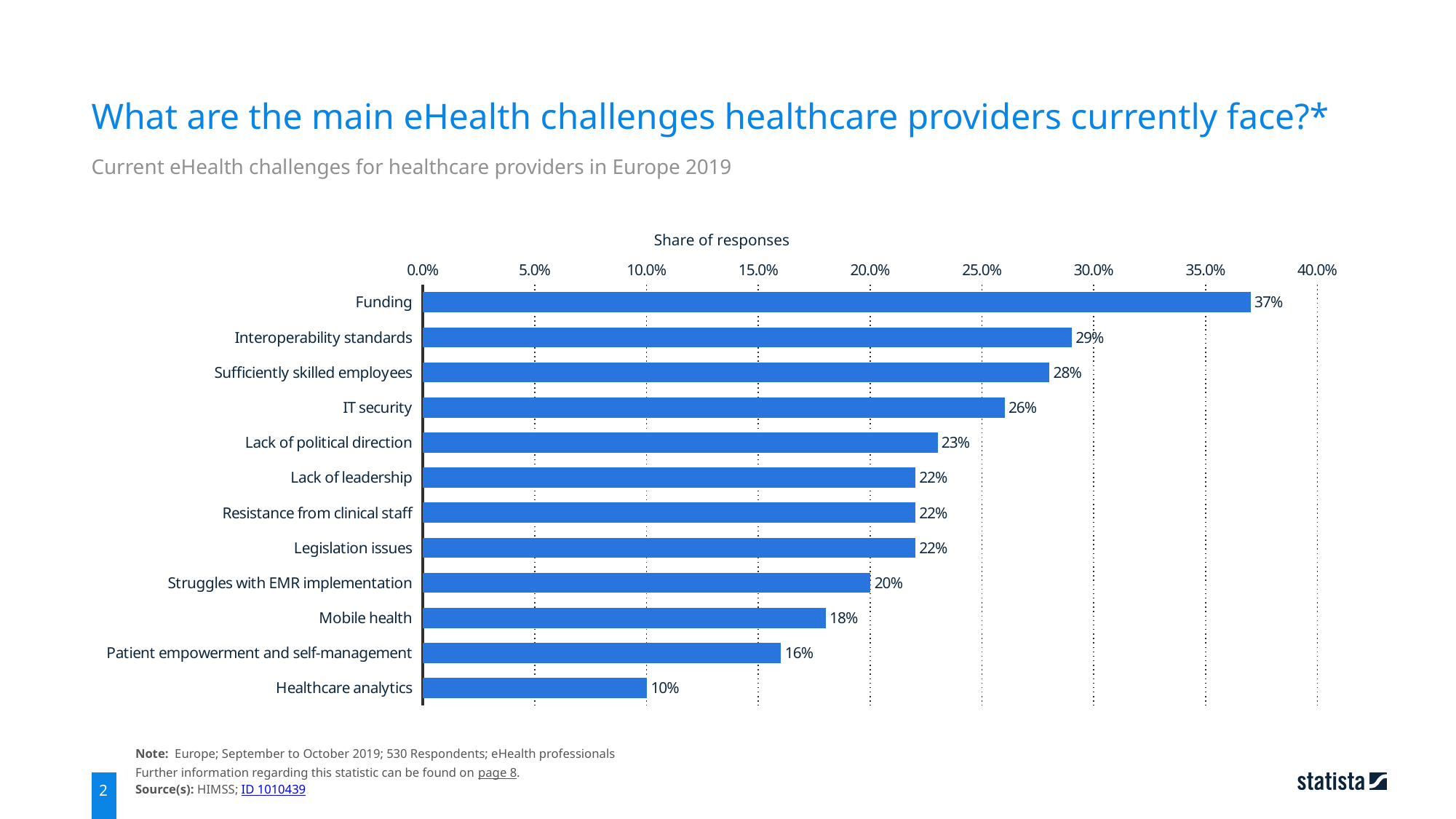
How many challenges are shown in the chart? 12 What is the difference in share of responses between Funding and Interoperability standards? 8% What is the difference in share of responses between Sufficiently skilled employees and Healthcare analytics? 18% Which has a larger share of responses, Lack of political direction or Struggles with EMR implementation? Lack of political direction Is the value for Patient empowerment and self-management greater or less than 20.0%? less Which challenge has the highest share of responses? Funding Which challenge has the lowest share of responses? Healthcare analytics What is the share of responses for IT security? 26% What kind of chart is shown on the slide? Bar chart What is the share of responses for Funding? 37% What is the label of the value axis of the chart? Share of responses What is the share of responses for Mobile health? 18%